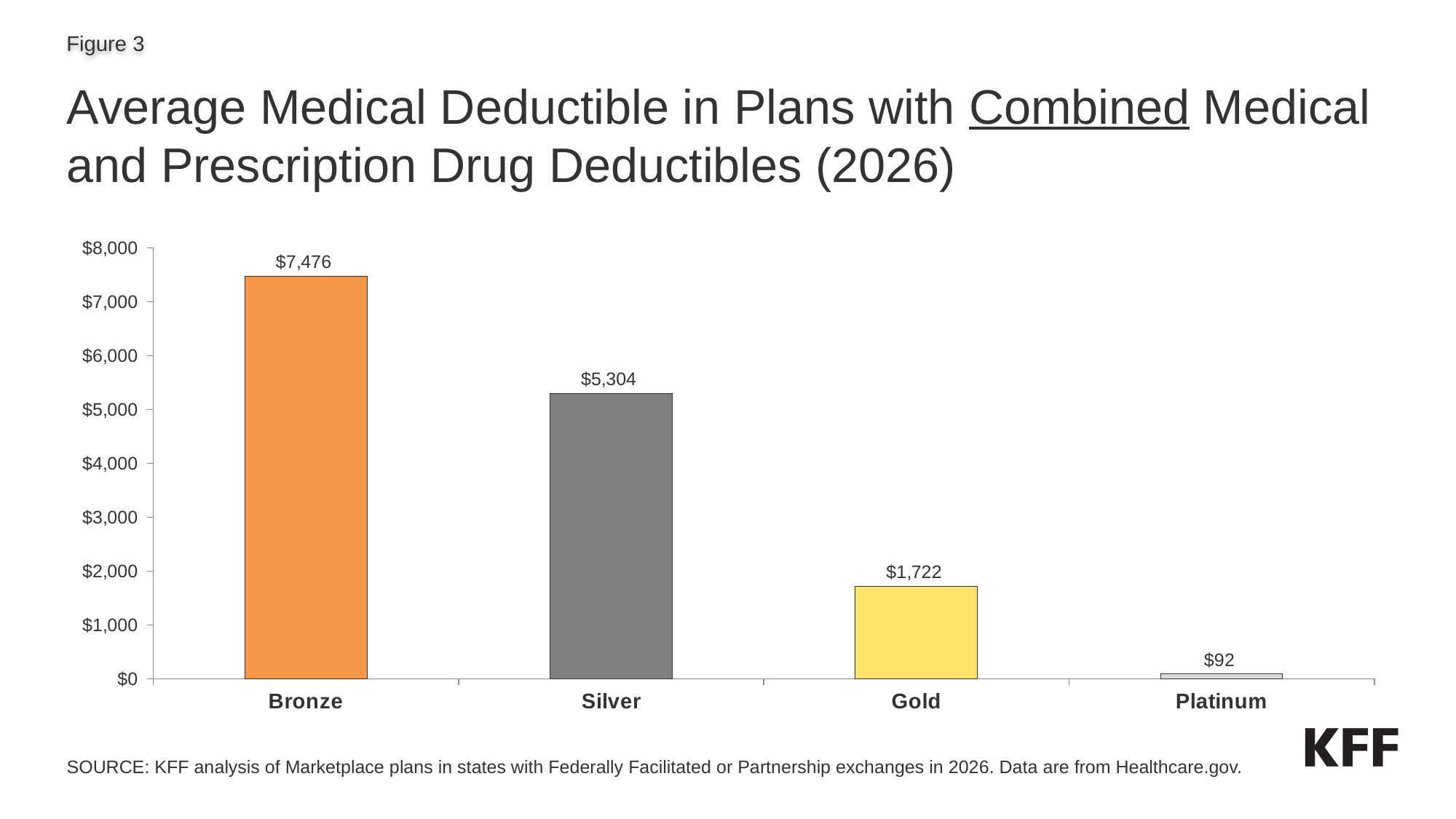
What is the difference between the Bronze and Silver average medical deductibles? $2,172 What is the average medical deductible for Silver plans? $5,304 What is the average medical deductible for Platinum plans? $92 What is the average medical deductible for Gold plans? $1,722 Which plan type has the lowest average medical deductible? Platinum How many plan types are shown on the chart? 4 Is the value for Gold greater or less than $2,000? less What is the difference between the Gold and Platinum average medical deductibles? $1,630 Which has a larger average medical deductible, Silver or Gold? Silver What kind of chart is shown on the slide? Bar chart Which plan type has the highest average medical deductible? Bronze What is the average medical deductible for Bronze plans? $7,476